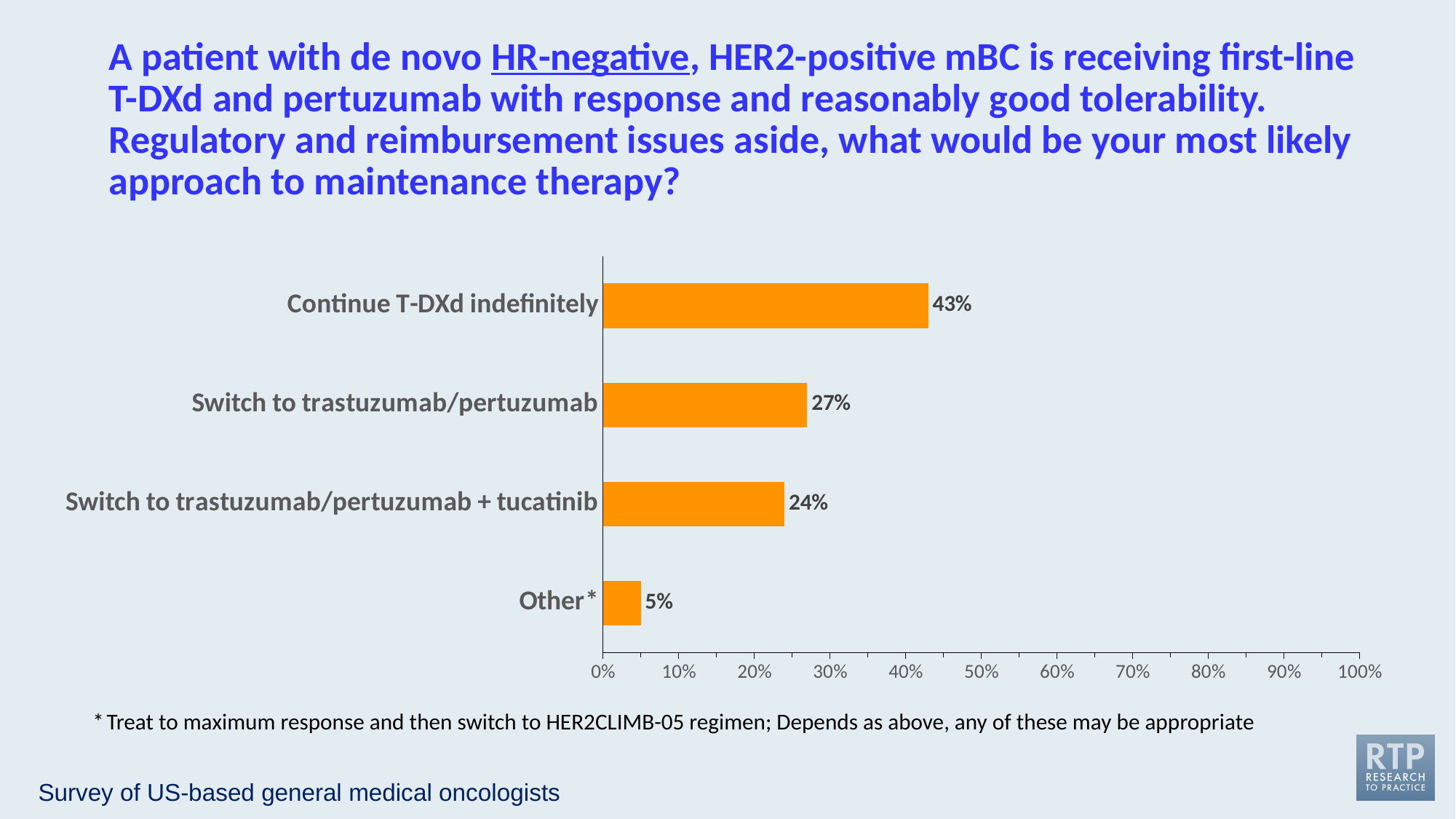
What percentage of respondents chose "Other"? 5% What is the difference in percentage points between "Continue T-DXd indefinitely" and "Switch to trastuzumab/pertuzumab"? 16 percentage points What percentage of respondents chose "Continue T-DXd indefinitely"? 43% Is the value for "Continue T-DXd indefinitely" greater or less than 50%? less Which received a larger share: "Switch to trastuzumab/pertuzumab" or "Switch to trastuzumab/pertuzumab + tucatinib"? Switch to trastuzumab/pertuzumab What type of chart is shown on the slide? Bar chart Which response option received the highest percentage? Continue T-DXd indefinitely How many response options are shown in the chart? 4 What percentage of respondents chose "Switch to trastuzumab/pertuzumab + tucatinib"? 24% What percentage of respondents chose "Switch to trastuzumab/pertuzumab"? 27% What is the maximum value shown on the horizontal axis? 100% Which response option received the lowest percentage? Other